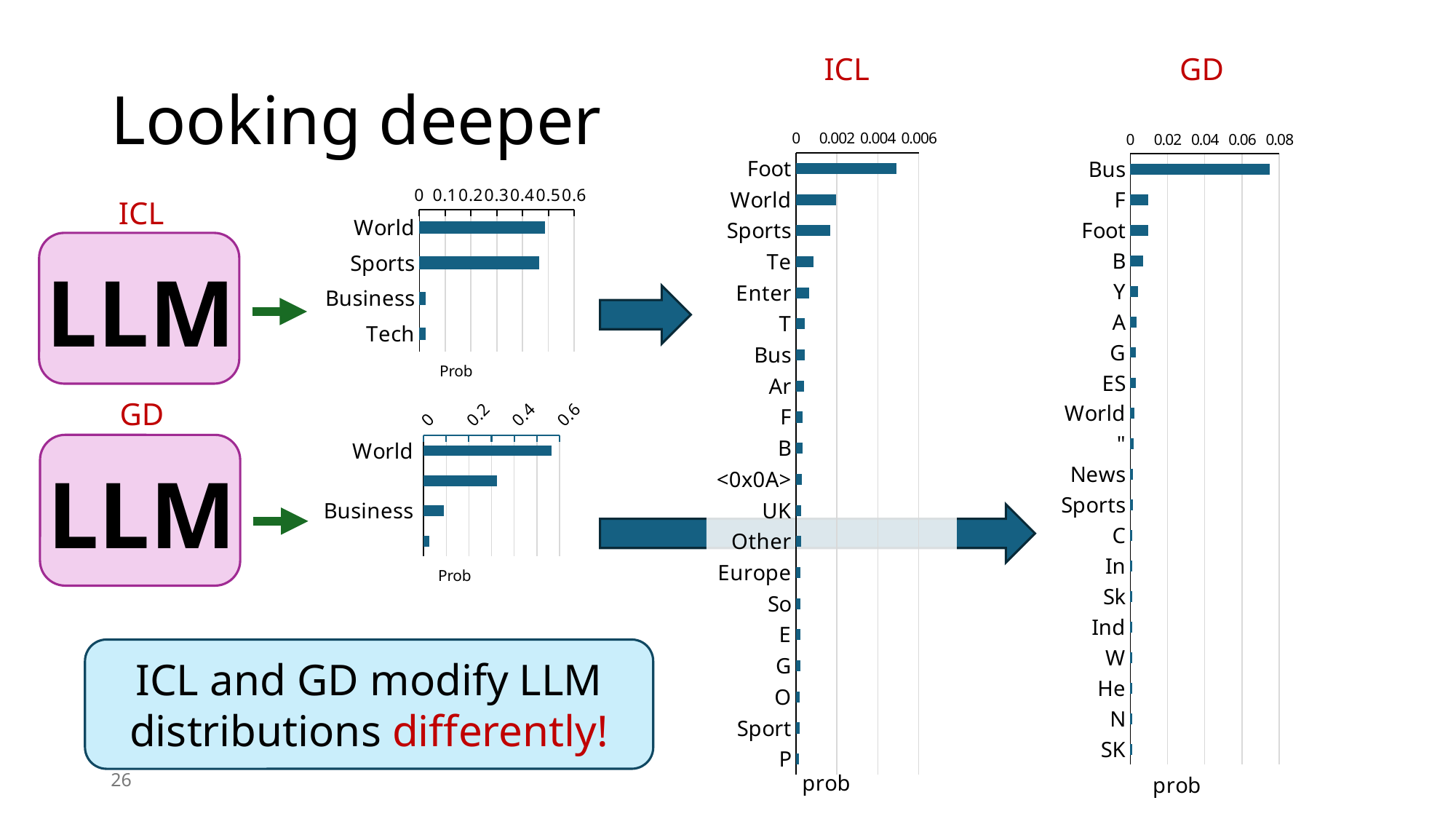
In the large GD chart on the far right, which category has the highest probability? Bus In the large GD chart on the far right, is the value for Bus greater or less than 0.06? greater What kind of chart is the large ICL chart on the right? bar chart In the large ICL chart on the right, is the value for World greater or less than 0.004? less In the large ICL chart on the right, which category has the highest probability? Foot In the large GD chart on the far right, which is larger, Bus or Foot? Bus How many categories are shown in the large ICL chart on the right? 20 In the large GD chart on the far right, is the value for F greater or less than 0.02? less In the small ICL chart at the top left, which is larger, World or Business? World How many categories are shown in the large GD chart on the far right? 20